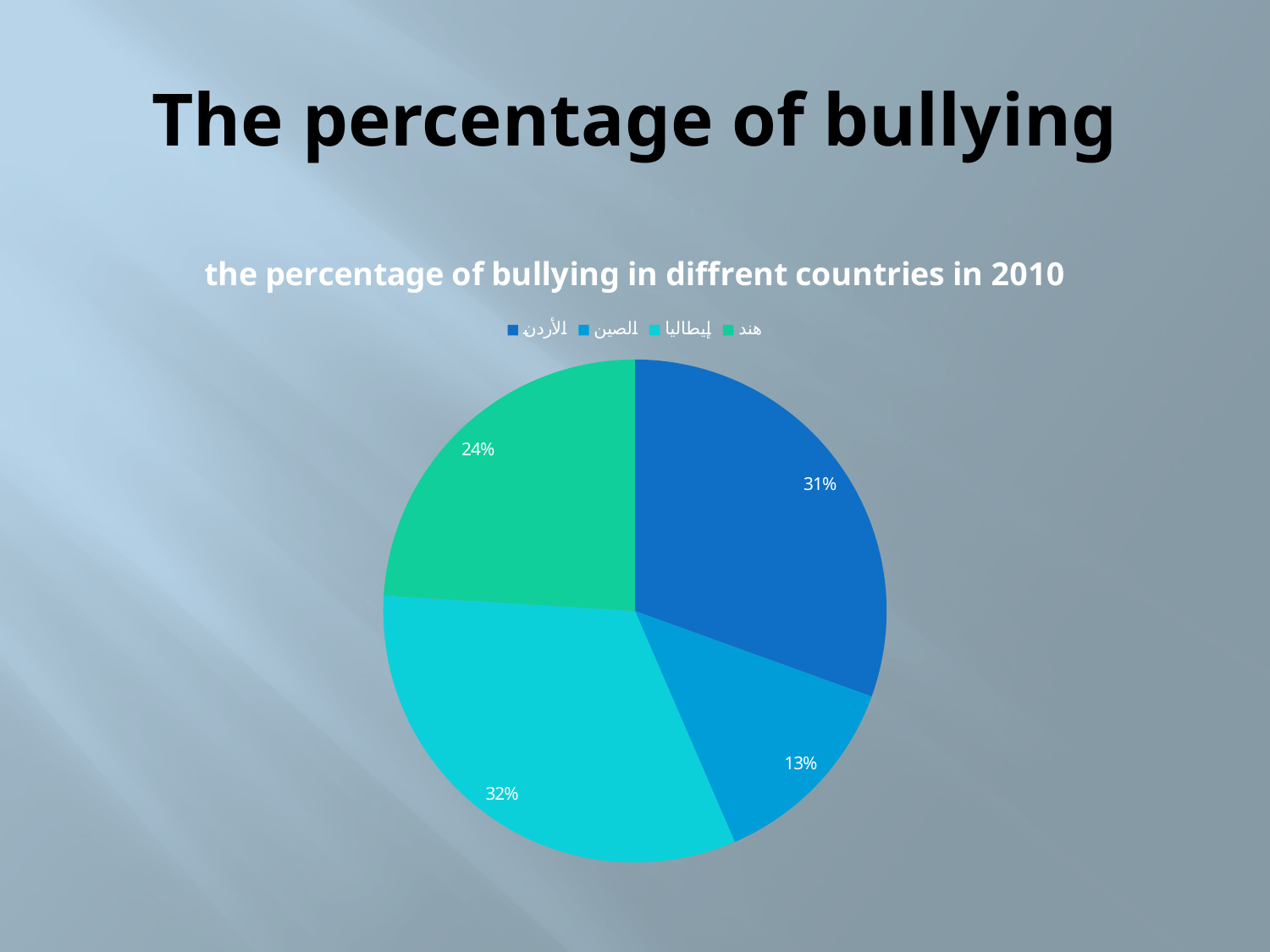
Which slice has the largest share of the pie? إيطاليا (32%) Which slice has the smallest share of the pie? الصين (13%) What is the title of the chart? the percentage of bullying in diffrent countries in 2010 What is the difference between the share for الأردن and the share for الصين? 18% What percentage is shown for the green slice (هند)? 24% How many entries does the legend list? 4 What percentage is shown for the cyan slice (إيطاليا)? 32% Which is larger, the share for هند or the share for الصين? هند What percentage is shown for the medium blue slice (الصين)? 13% How many slices does the pie chart have? 4 What percentage is shown for the dark blue slice (الأردن)? 31% What kind of chart is shown on the slide? pie chart